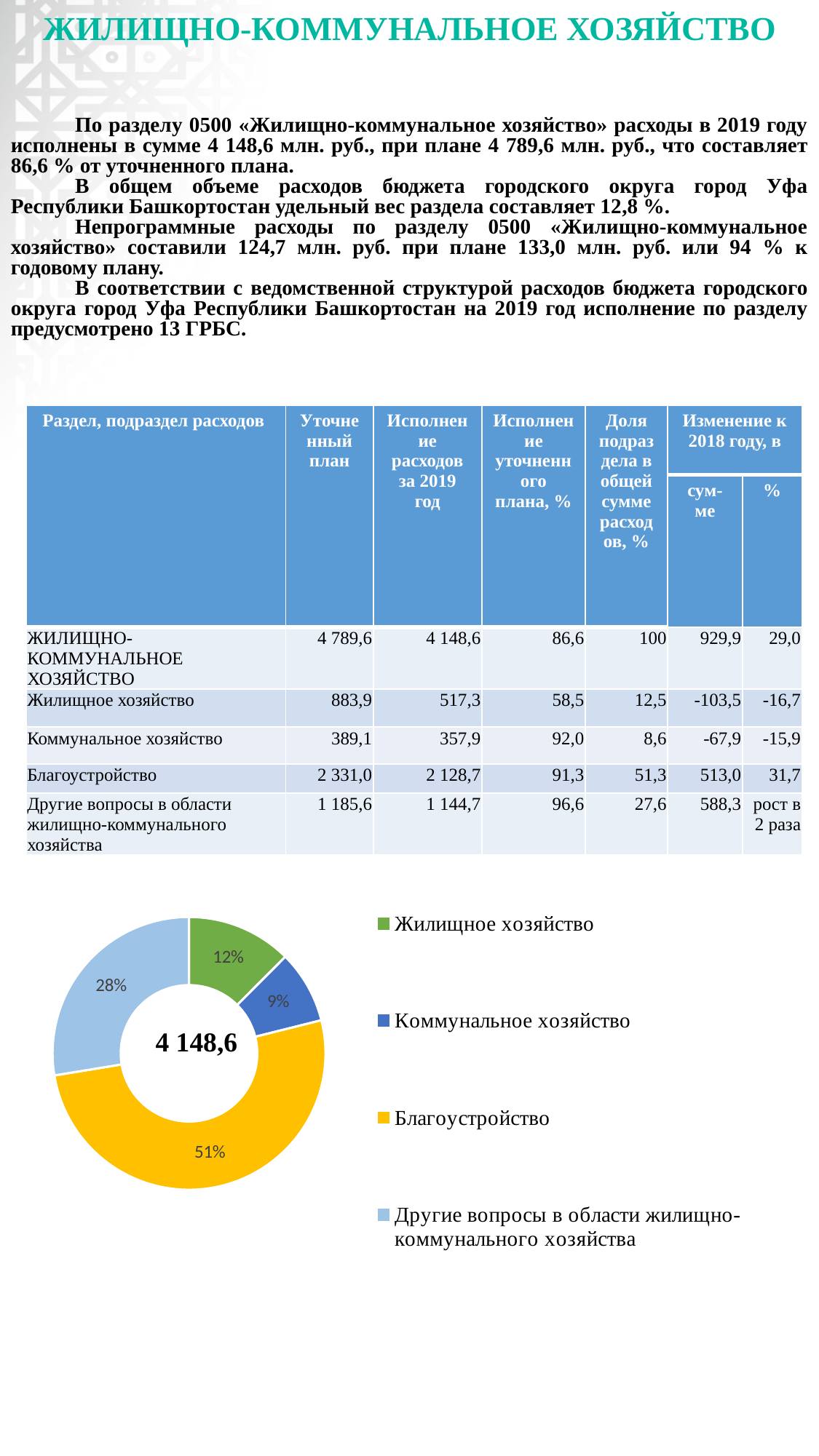
What is the difference in percentage points between the Благоустройство slice and the Другие вопросы в области жилищно-коммунального хозяйства slice? 23 percentage points Which category has the smallest slice in the doughnut chart? Коммунальное хозяйство What share of the doughnut chart does Благоустройство have? 51% What type of chart is shown on the slide? Doughnut (pie) chart Which slice is larger in the doughnut chart: Жилищное хозяйство or Другие вопросы в области жилищно-коммунального хозяйства? Другие вопросы в области жилищно-коммунального хозяйства How many categories are shown in the doughnut chart? 4 What share of the doughnut chart does Другие вопросы в области жилищно-коммунального хозяйства have? 28% What share of the doughnut chart does Коммунальное хозяйство have? 9% What colour is the Благоустройство slice in the doughnut chart? Yellow Which category has the largest slice in the doughnut chart? Благоустройство What value is printed in the centre of the doughnut chart? 4 148,6